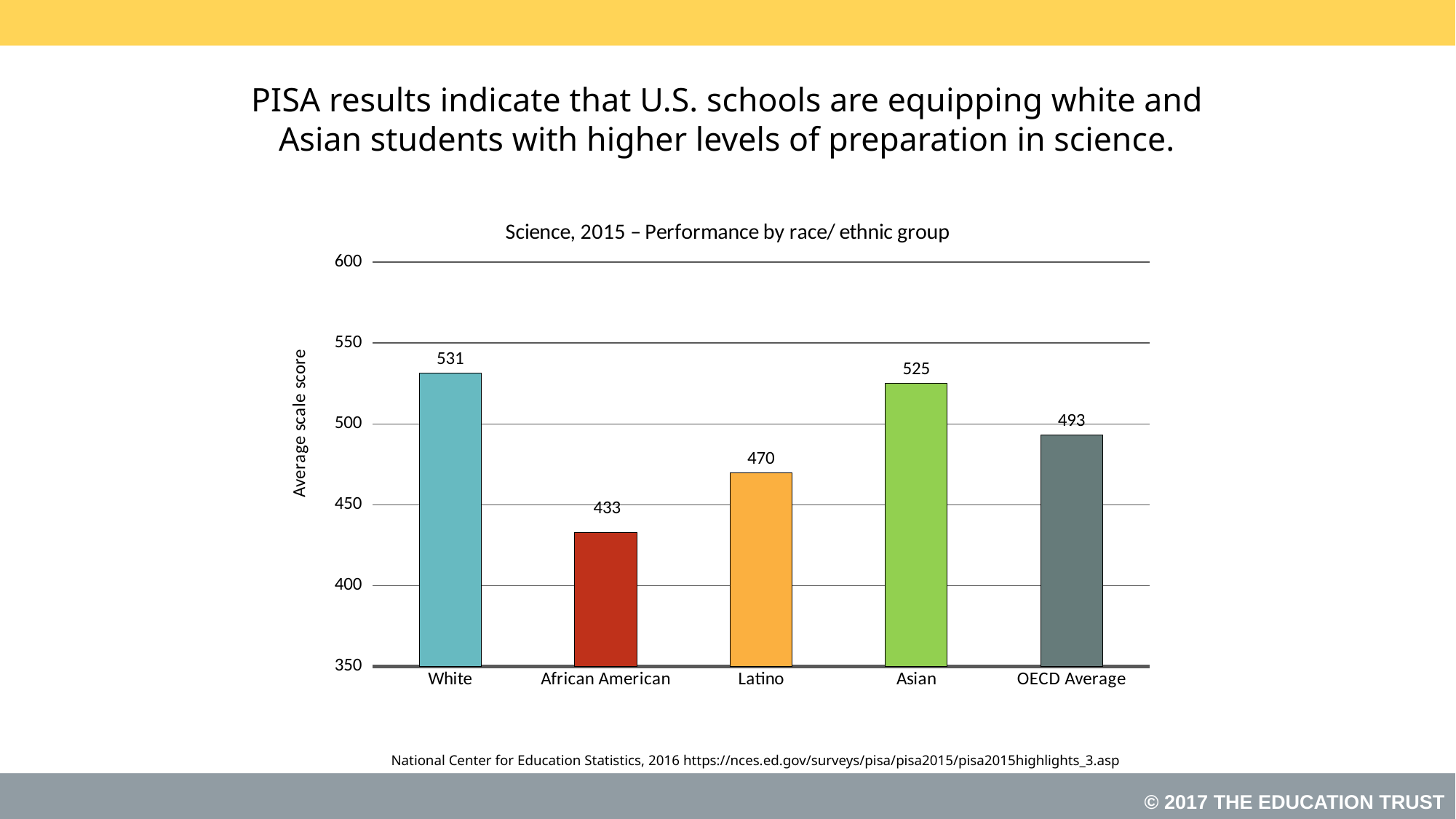
How many categories are shown on the x axis? 5 What is the average scale score for Latino students? 470 What is the OECD Average score shown on the chart? 493 What is the title of the chart? Science, 2015 – Performance by race/ ethnic group Which is larger, the Latino score or the OECD Average? OECD Average Which group has the lowest average scale score? African American What is the difference between the White and African American scores? 98 What kind of chart is shown on the slide? Bar chart What is the average scale score for White students? 531 Which group has the highest average scale score? White What is the difference between the Asian score and the OECD Average? 32 What is the average scale score for African American students? 433